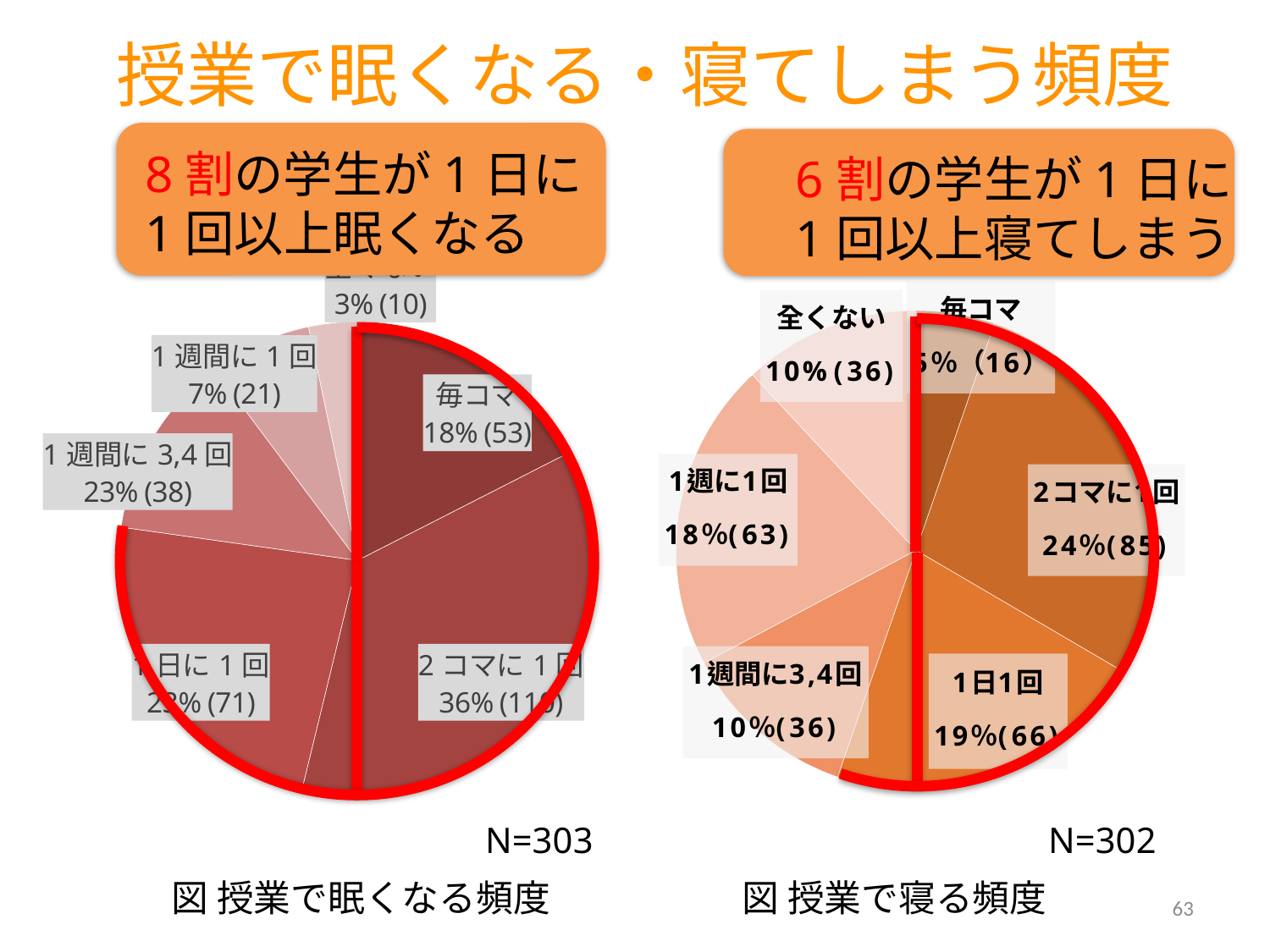
In the right pie chart (授業で寝る頻度), which category has the smallest share? 毎コマ In the right pie chart (授業で寝る頻度), what percentage and count are shown for 1週間に3,4回? 10%(36) In the left pie chart (授業で眠くなる頻度), which category has the largest share? 2コマに1回 In the right pie chart (授業で寝る頻度), what percentage and count are shown for 1週に1回? 18%(63) In the left pie chart (授業で眠くなる頻度), which is larger: 毎コマ or 1週間に1回? 毎コマ What kind of chart is used in the figure 授業で眠くなる頻度 on the left? Pie chart In the left pie chart (授業で眠くなる頻度), what percentage and count are shown for 毎コマ? 18% (53) In the right pie chart (授業で寝る頻度), which category has the largest share? 2コマに1回 In the left pie chart (授業で眠くなる頻度), how many percentage points larger is 2コマに1回 (36%) than 毎コマ (18%)? 18 percentage points How many slices does the right pie chart (授業で寝る頻度) have? 6 In the left pie chart (授業で眠くなる頻度), what percentage and count are shown for 1週間に1回? 7% (21) What is the sample size (N) shown under the right pie chart (授業で寝る頻度)? N=302